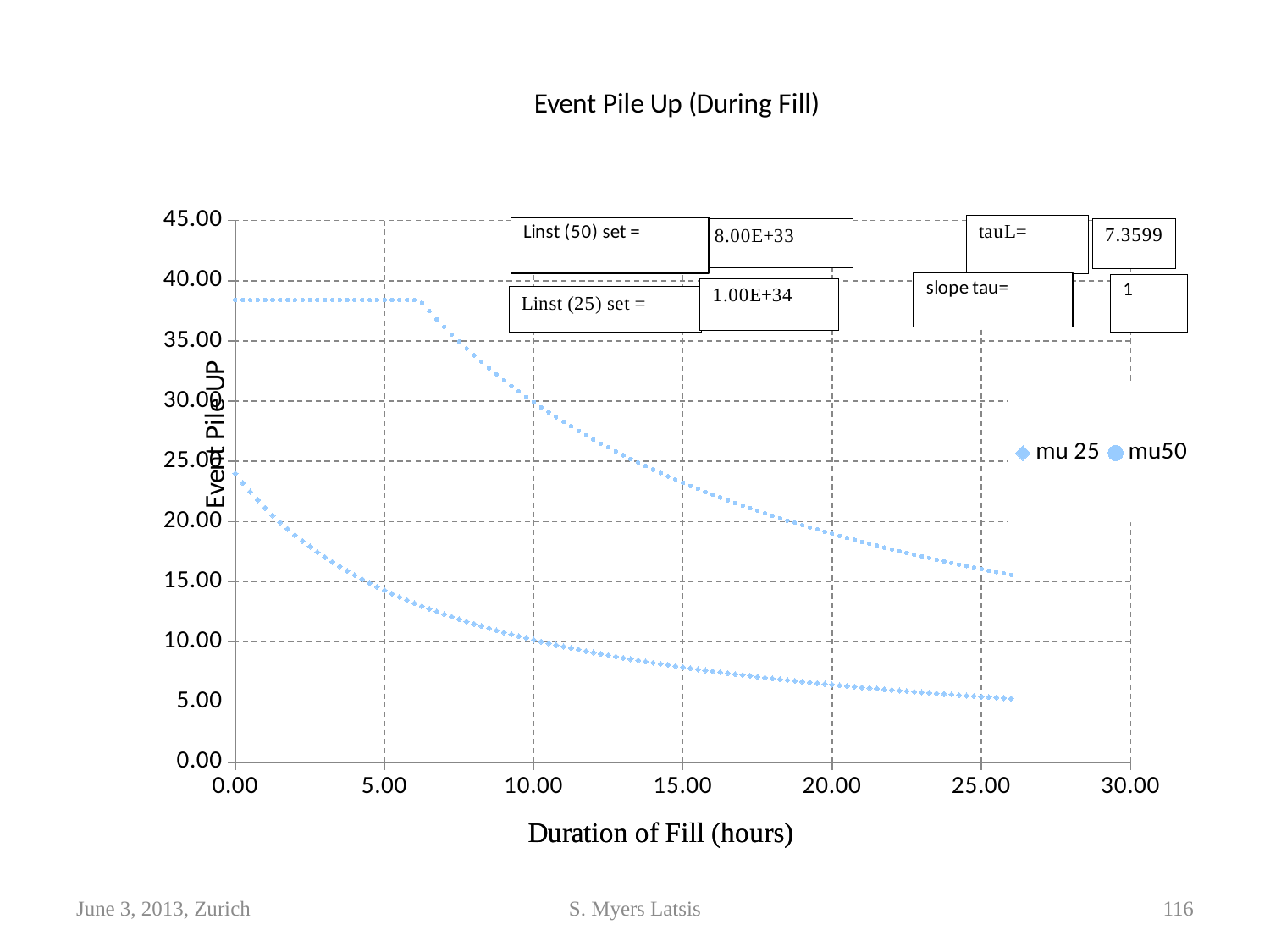
After about 6 hours, does the mu50 series rise or fall as the duration of fill increases? fall Does the mu 25 series rise or fall as the duration of fill increases? fall How many series does the legend list? 2 Is the value for mu 25 at 15.00 hours greater or less than 10.00? less What is the label of the x axis? Duration of Fill (hours) What is the title of the chart? Event Pile Up (During Fill) Is the value for mu 25 at 25.00 hours greater or less than 10.00? less What kind of chart is shown on the slide? scatter chart At 10.00 hours, which series has the higher event pile up, mu 25 or mu50? mu50 Is the value for mu 25 at 0.00 hours greater or less than 20.00? greater